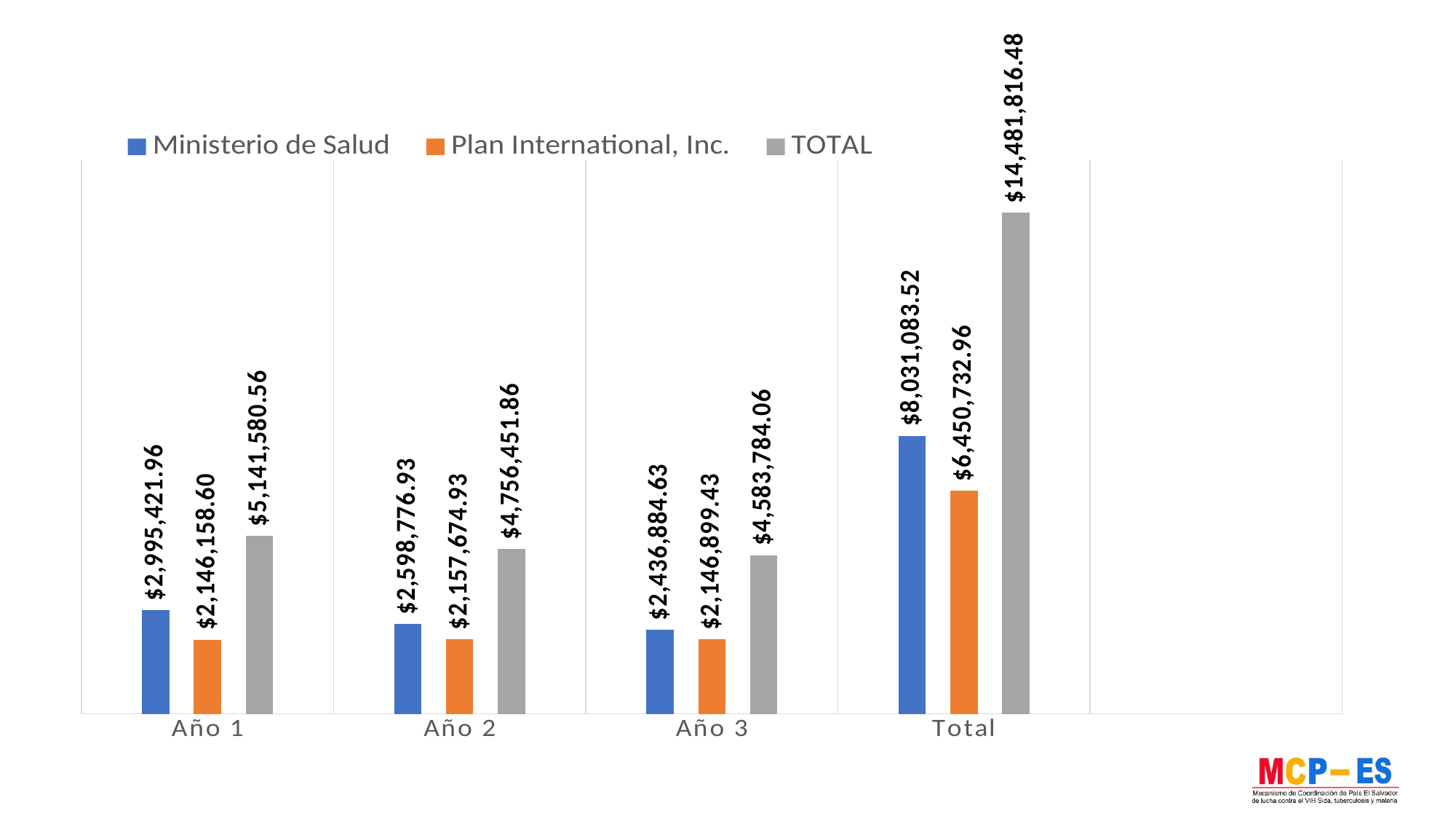
How many categories are shown on the x axis? 4 What kind of chart is shown on the slide? Bar chart In Año 2, which is larger: Ministerio de Salud or Plan International, Inc.? Ministerio de Salud What is the TOTAL value for Año 3? $4,583,784.06 What is the value for Plan International, Inc. in Año 2? $2,157,674.93 How many series does the legend list? 3 What is the difference between the Ministerio de Salud values for Año 1 and Año 3? $558,537.33 What is the TOTAL value in the Total category? $14,481,816.48 Among Año 1, Año 2 and Año 3, in which year is the Ministerio de Salud value highest? Año 1 What is the value for Ministerio de Salud in Año 1? $2,995,421.96 In the Total category, what is the difference between Ministerio de Salud and Plan International, Inc.? $1,580,350.56 Do the Ministerio de Salud values rise or fall from Año 1 to Año 3? Fall